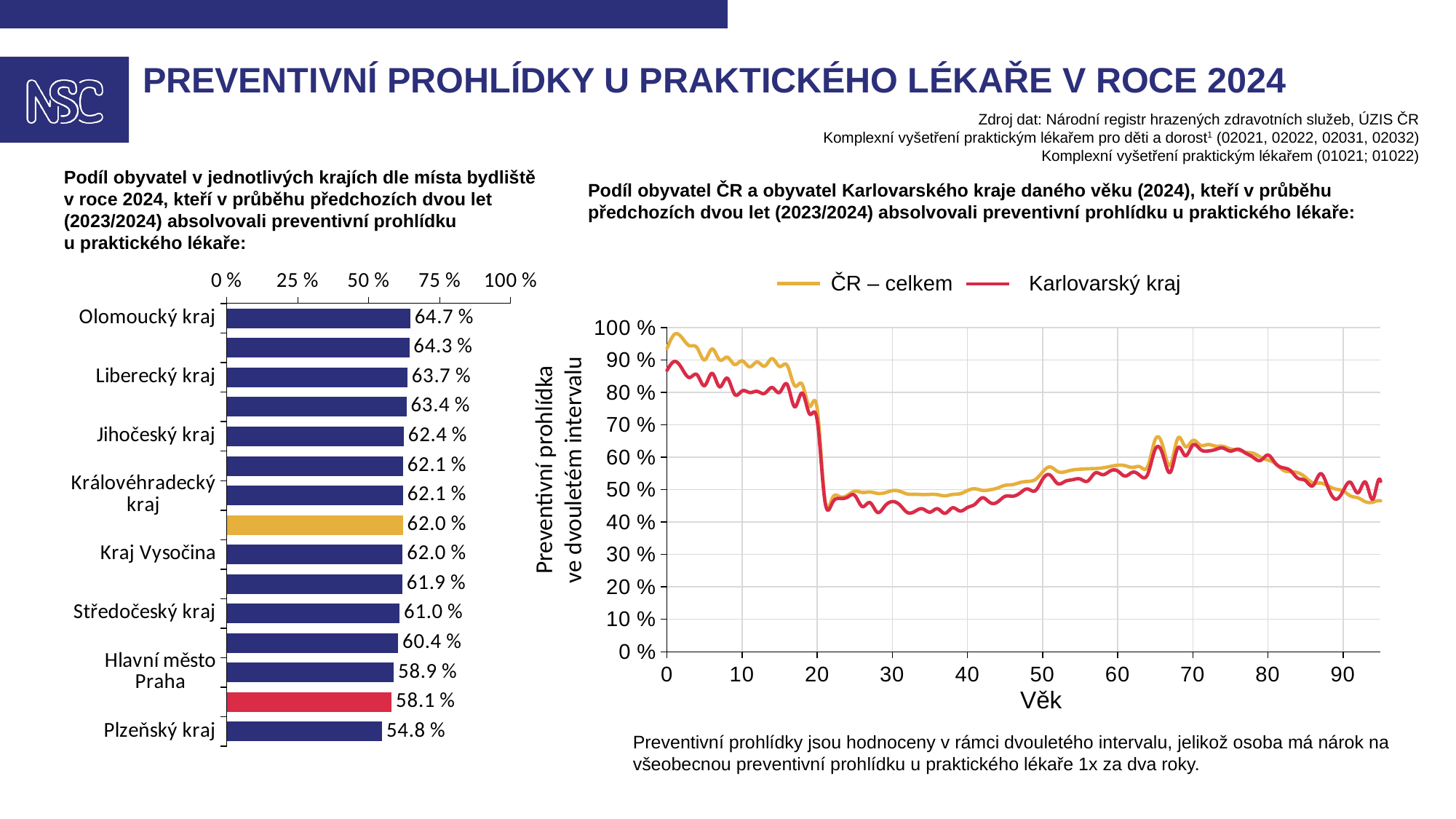
In the bar chart on the left, which region has the lowest value? Plzeňský kraj In the bar chart on the left, what is the value for Hlavní město Praha? 58.9 % In the line chart on the right, how many series does the legend list? 2 In the bar chart on the left, which region has the highest value? Olomoucký kraj In the bar chart on the left, what is the value for Plzeňský kraj? 54.8 % In the bar chart on the left, what is the difference between the values for Olomoucký kraj and Plzeňský kraj? 9.9 % In the line chart on the right, is the value for ČR – celkem at age 0 greater or less than 90 %? greater In the bar chart on the left, what is the value for Olomoucký kraj? 64.7 % In the line chart on the right, is the value for Karlovarský kraj at age 30 greater or less than 50 %? less In the bar chart on the left, how many bars are plotted? 15 In the bar chart on the left, which has the larger value, Liberecký kraj or Středočeský kraj? Liberecký kraj What kind of chart is the chart on the left? bar chart